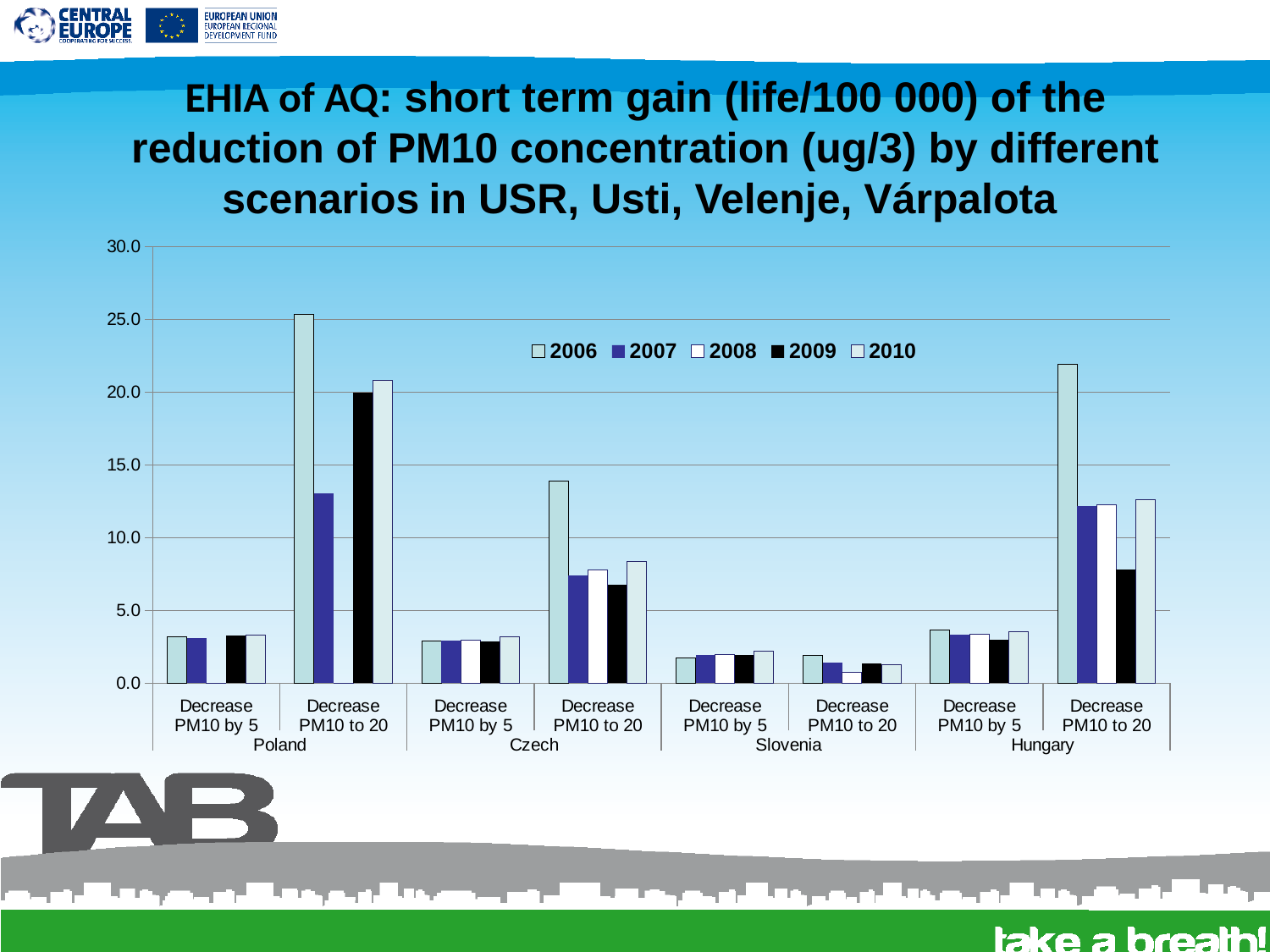
What kind of chart is shown on the slide? bar chart Which country and scenario has the tallest bar in the chart? Poland, Decrease PM10 to 20 (2006) How many series does the legend list? 5 For Hungary 'Decrease PM10 to 20', which is larger: the 2006 value or the 2009 value? 2006 Is the 2009 value for Hungary 'Decrease PM10 to 20' greater or less than 10.0? less For Poland 'Decrease PM10 to 20', which is larger: the 2006 value or the 2007 value? 2006 Is the 2006 value for Czech 'Decrease PM10 to 20' greater or less than 10.0? greater Which years are listed in the legend? 2006, 2007, 2008, 2009, 2010 Is the 2009 value for Poland 'Decrease PM10 to 20' greater or less than 15.0? greater How many countries are shown along the x axis? 4 How many scenario categories are shown along the x axis in total? 8